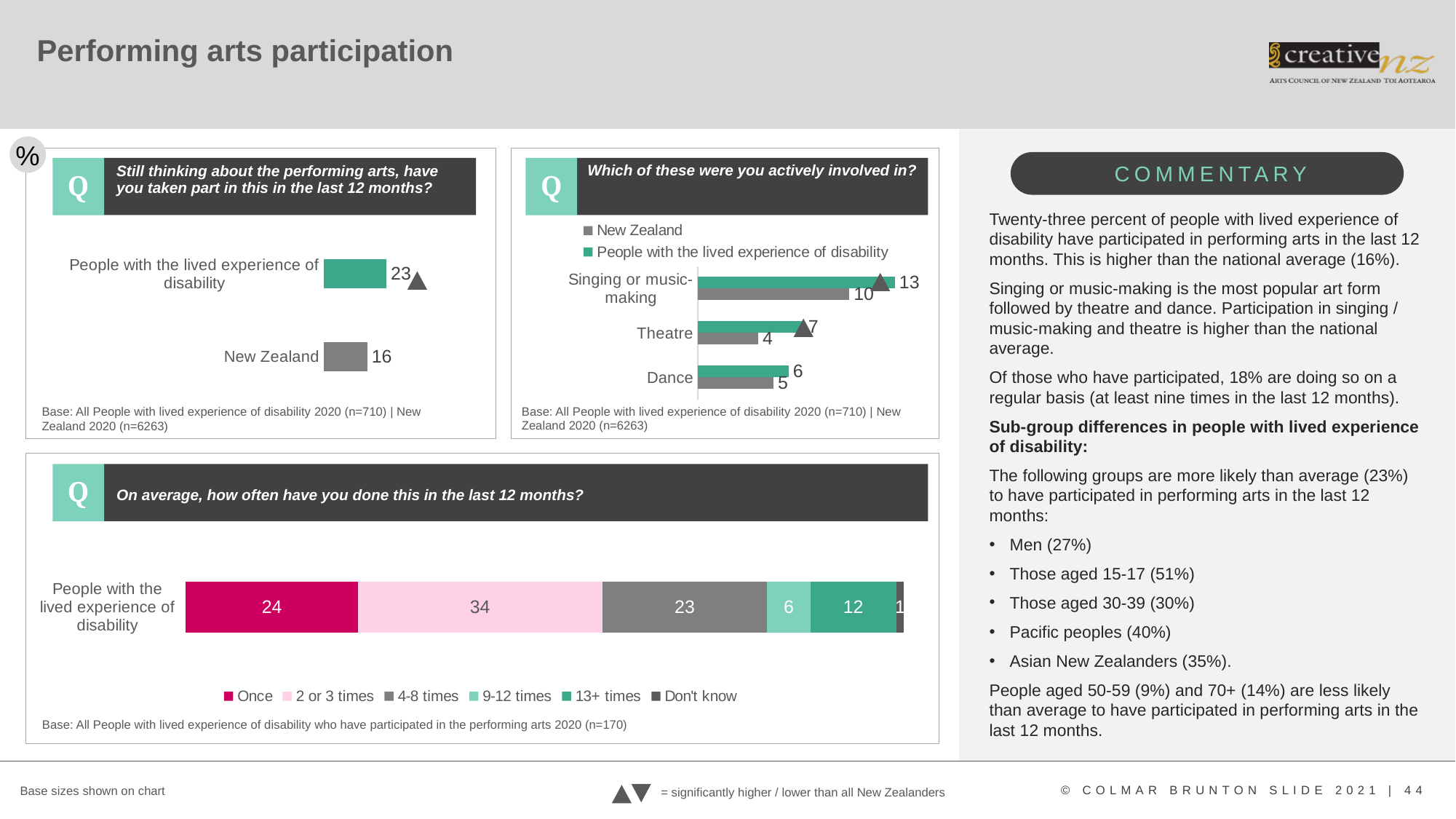
In the bottom chart ('how often have you done this in the last 12 months?'), how many series does the legend list? 6 In the bottom chart ('how often have you done this in the last 12 months?'), what is the value for the '2 or 3 times' segment? 34 In the top-middle chart ('Which of these were you actively involved in?'), which category has the highest value for People with the lived experience of disability? Singing or music-making In the top-middle chart ('Which of these were you actively involved in?'), what is the value for Theatre for People with the lived experience of disability? 7 In the top-left chart ('have you taken part in this in the last 12 months?'), what is the value for People with the lived experience of disability? 23 In the top-left chart ('have you taken part in this in the last 12 months?'), what is the value for New Zealand? 16 In the top-middle chart ('Which of these were you actively involved in?'), how many categories are shown? 3 In the top-left chart ('have you taken part in this in the last 12 months?'), what is the difference between the value for People with the lived experience of disability and the value for New Zealand? 7 In the top-middle chart ('Which of these were you actively involved in?'), what is the New Zealand value for Singing or music-making? 10 In the bottom chart ('how often have you done this in the last 12 months?'), which segment is larger: 'Once' or '4-8 times'? Once In the top-middle chart ('Which of these were you actively involved in?'), how many series does the legend list? 2 In the top-middle chart ('Which of these were you actively involved in?'), which category has the lowest New Zealand value? Theatre